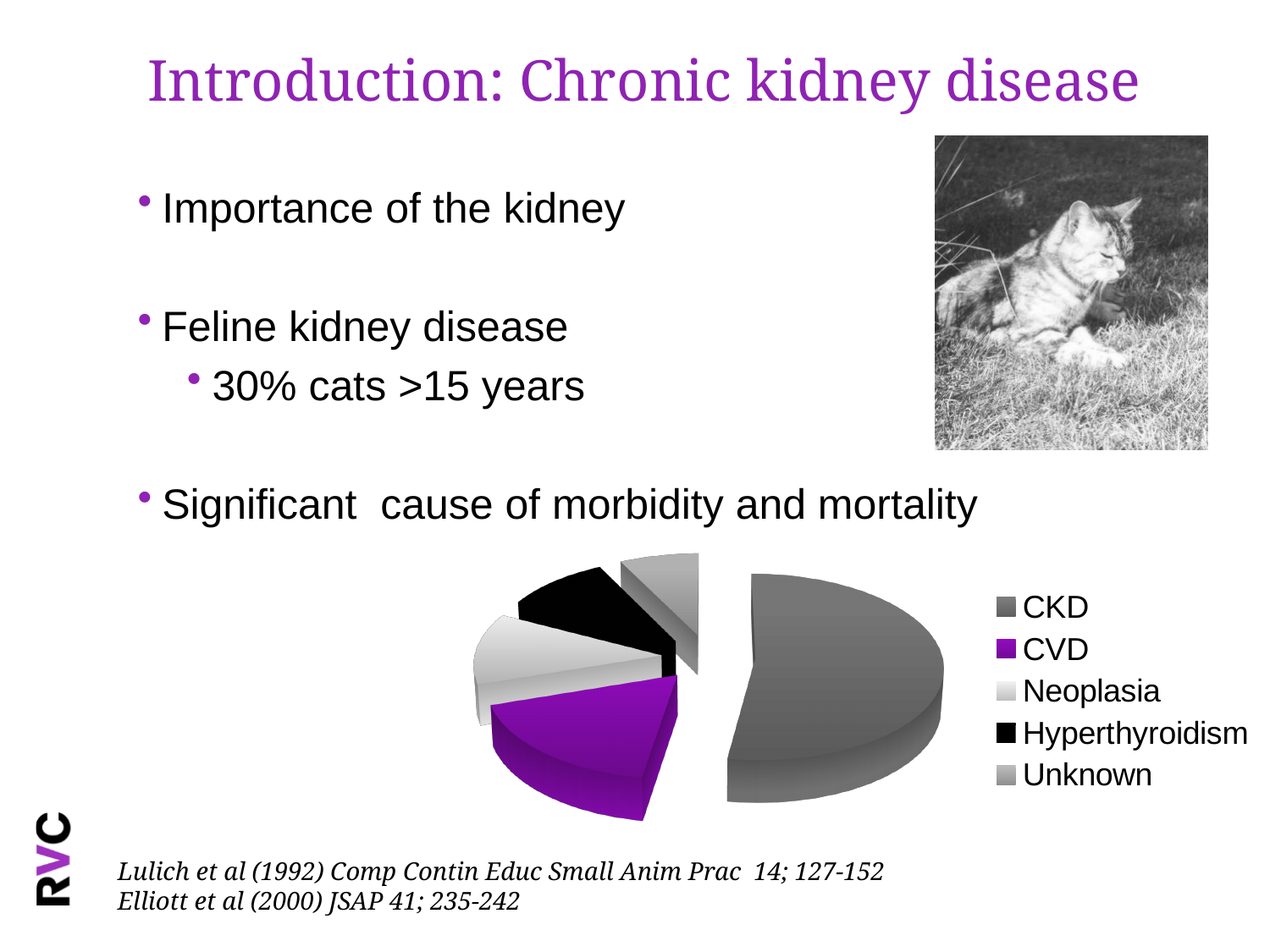
How many slices does the pie chart have? 5 Which slice is larger in the pie chart, CKD or Neoplasia? CKD Which category has the largest slice in the pie chart? CKD Which slice is larger in the pie chart, CKD or CVD? CKD What kind of chart is shown on the slide? pie chart What colour is the CVD slice in the pie chart? purple How many entries does the legend of the pie chart list? 5 Which slice is larger in the pie chart, CKD or Hyperthyroidism? CKD Which legend entry of the pie chart is shown in black? Hyperthyroidism